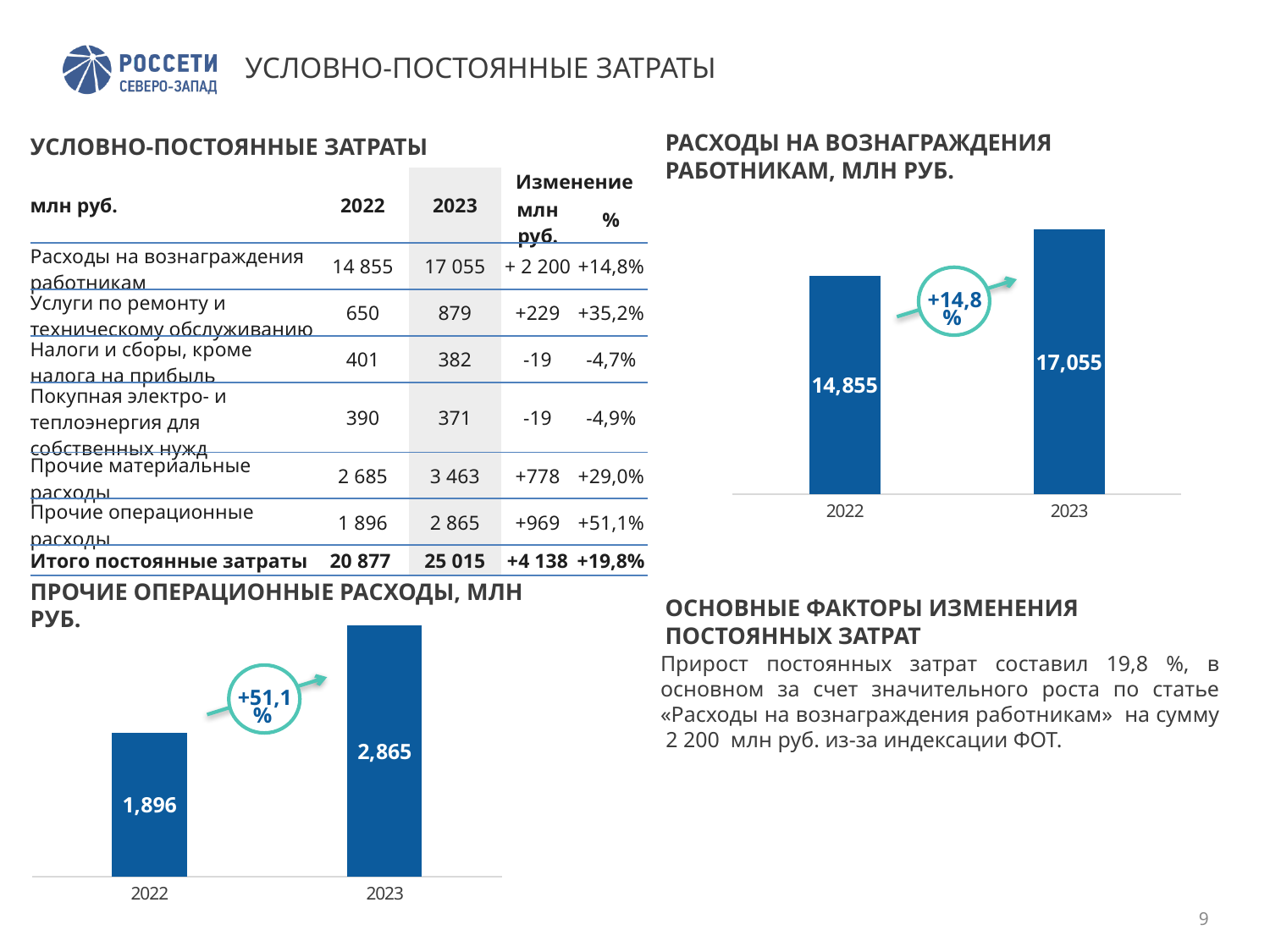
In the chart 'ПРОЧИЕ ОПЕРАЦИОННЫЕ РАСХОДЫ, МЛН РУБ.', do the values rise or fall from 2022 to 2023? rise In the chart 'ПРОЧИЕ ОПЕРАЦИОННЫЕ РАСХОДЫ, МЛН РУБ.', what is the value for 2022? 1,896 How many bars are shown in the chart 'РАСХОДЫ НА ВОЗНАГРАЖДЕНИЯ РАБОТНИКАМ, МЛН РУБ.'? 2 In the chart 'ПРОЧИЕ ОПЕРАЦИОННЫЕ РАСХОДЫ, МЛН РУБ.', what is the value for 2023? 2,865 What type of chart is 'ПРОЧИЕ ОПЕРАЦИОННЫЕ РАСХОДЫ, МЛН РУБ.'? bar chart In the chart 'РАСХОДЫ НА ВОЗНАГРАЖДЕНИЯ РАБОТНИКАМ, МЛН РУБ.', what is the value for 2022? 14,855 In the chart 'РАСХОДЫ НА ВОЗНАГРАЖДЕНИЯ РАБОТНИКАМ, МЛН РУБ.', what percentage change is shown in the circle annotation between 2022 and 2023? +14,8% In the chart 'ПРОЧИЕ ОПЕРАЦИОННЫЕ РАСХОДЫ, МЛН РУБ.', what is the difference between the 2023 and 2022 values? 969 In the chart 'ПРОЧИЕ ОПЕРАЦИОННЫЕ РАСХОДЫ, МЛН РУБ.', which year has the lower value? 2022 In the chart 'РАСХОДЫ НА ВОЗНАГРАЖДЕНИЯ РАБОТНИКАМ, МЛН РУБ.', which year has the higher value? 2023 In the chart 'РАСХОДЫ НА ВОЗНАГРАЖДЕНИЯ РАБОТНИКАМ, МЛН РУБ.', what is the difference between the 2023 and 2022 values? 2,200 In the chart 'РАСХОДЫ НА ВОЗНАГРАЖДЕНИЯ РАБОТНИКАМ, МЛН РУБ.', what is the value for 2023? 17,055